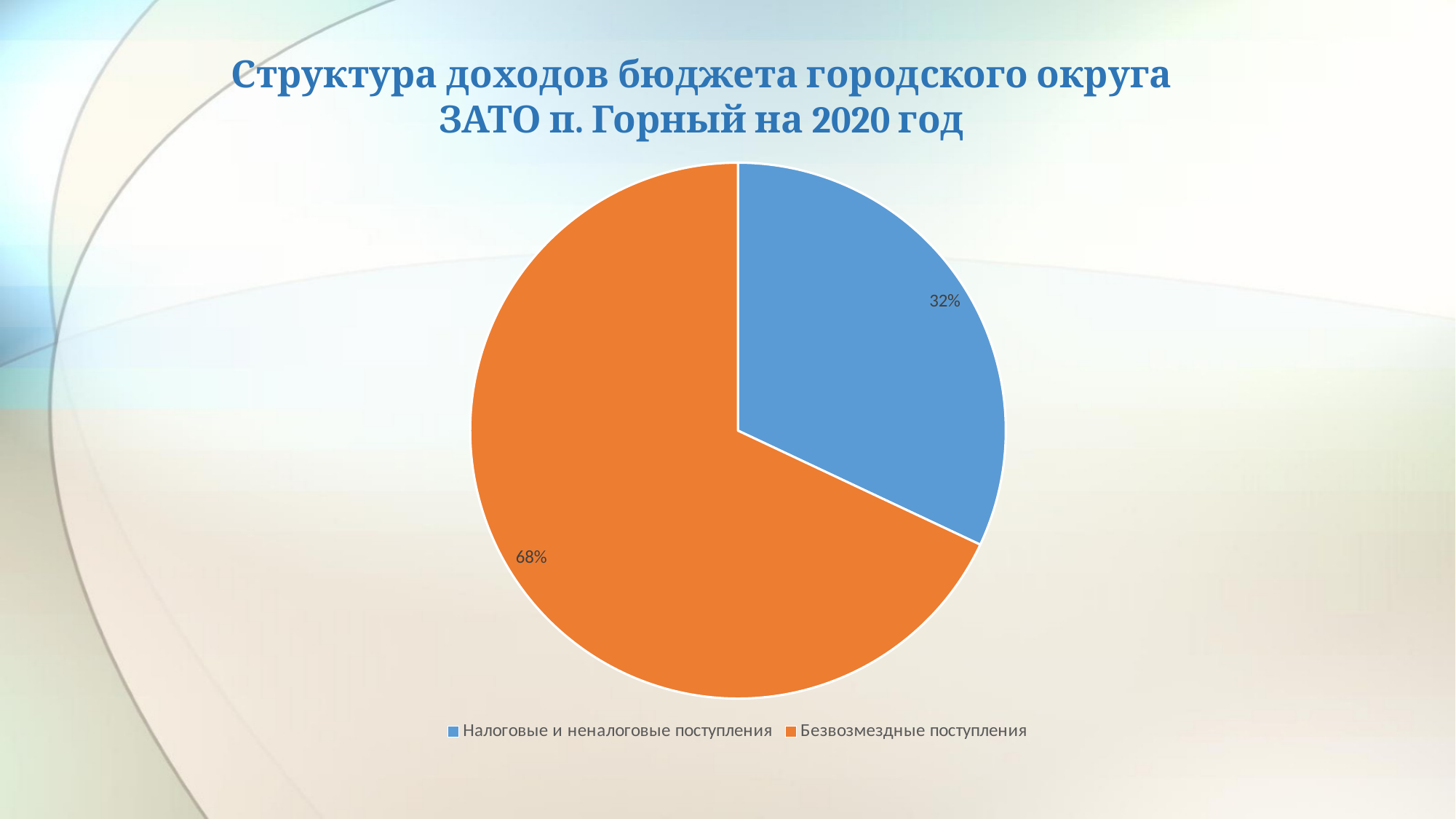
How many entries does the legend list? 2 What is the difference in percentage points between the "Безвозмездные поступления" slice and the "Налоговые и неналоговые поступления" slice? 36 percentage points Is the share for "Налоговые и неналоговые поступления" greater or less than 50%? less What share of the pie does "Безвозмездные поступления" represent? 68% Which category has the smallest slice of the pie? Налоговые и неналоговые поступления Which is larger: the slice for "Налоговые и неналоговые поступления" or the slice for "Безвозмездные поступления"? Безвозмездные поступления What colour is the slice for "Безвозмездные поступления"? Orange What kind of chart is shown on the slide? Pie chart How many slices does the pie chart have? 2 What share of the pie does "Налоговые и неналоговые поступления" represent? 32% What is the title of the chart? Структура доходов бюджета городского округа ЗАТО п. Горный на 2020 год Which category has the largest slice of the pie? Безвозмездные поступления